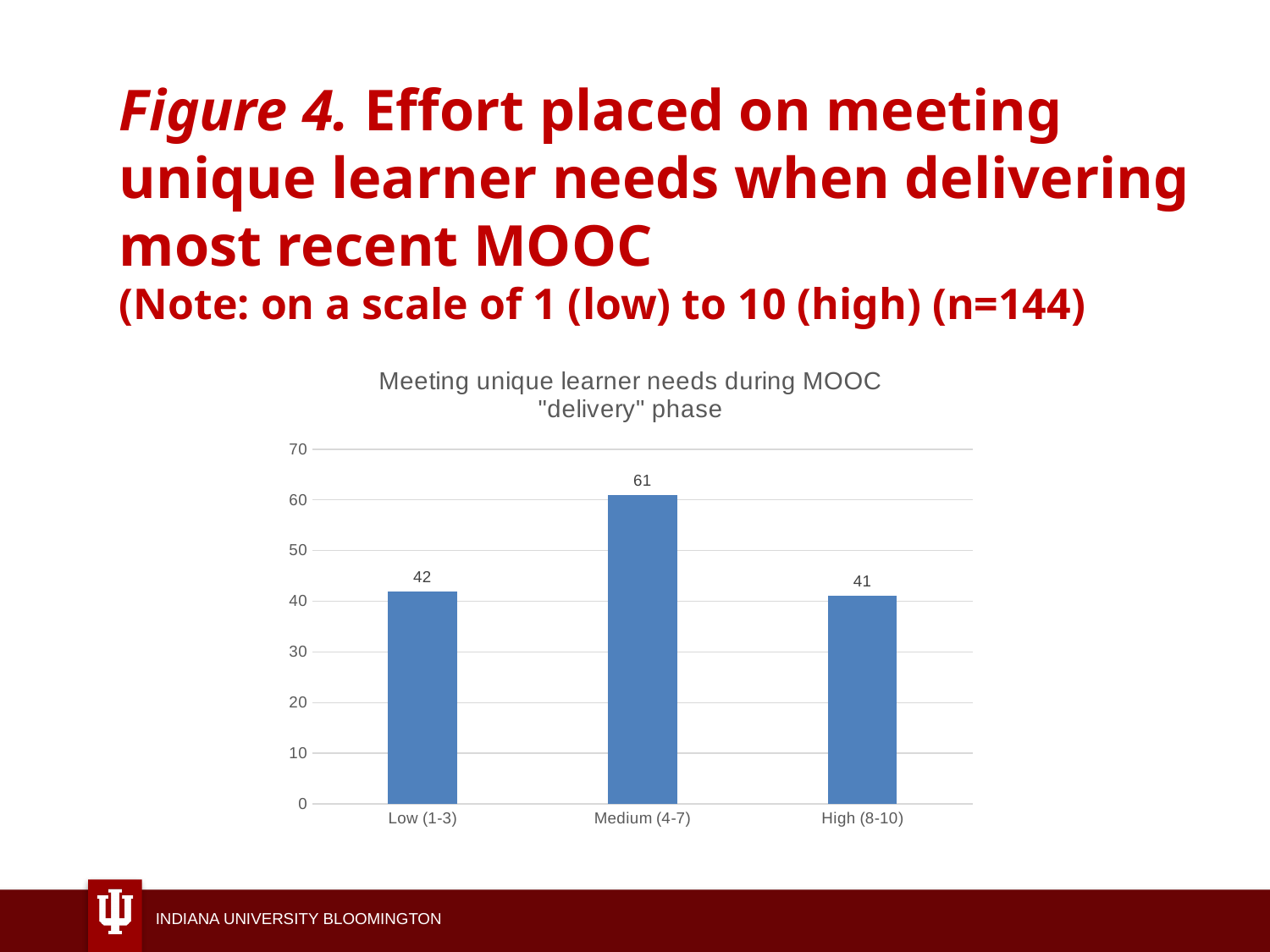
What is the value for High (8-10)? 41 Which is larger, the value for Medium (4-7) or the value for High (8-10)? Medium (4-7) What is the title of the chart? Meeting unique learner needs during MOOC "delivery" phase Is the value for Medium (4-7) greater or less than 50? greater What kind of chart is shown on the slide? bar chart What is the difference between the values for Medium (4-7) and Low (1-3)? 19 What is the difference between the values for Low (1-3) and High (8-10)? 1 What is the value for Medium (4-7)? 61 What is the value for Low (1-3)? 42 How many categories are shown on the x axis? 3 Which category has the lowest value? High (8-10) Which category has the highest value? Medium (4-7)